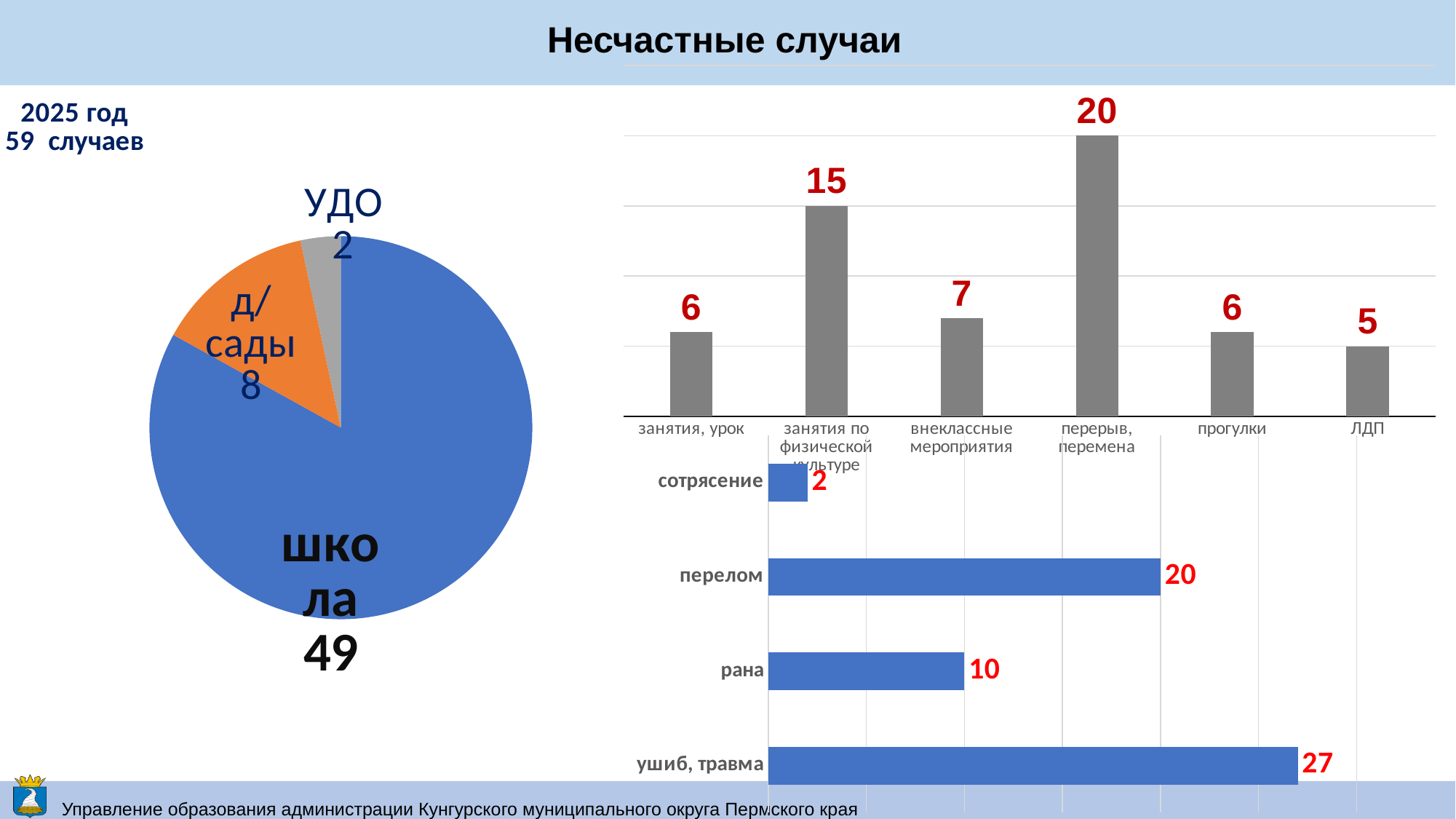
In the vertical bar chart at the top right, how many categories are shown? 6 In the vertical bar chart at the top right, what is the value for перерыв, перемена? 20 In the horizontal bar chart at the bottom right, what is the value for рана? 10 What kind of chart is shown at the bottom right of the slide? bar chart In the pie chart on the left, what is the value for школа? 49 In the horizontal bar chart at the bottom right, which category has the highest value? ушиб, травма In the horizontal bar chart at the bottom right, which is larger: перелом or сотрясение? перелом In the vertical bar chart at the top right, what is the difference between занятия по физической культуре and внеклассные мероприятия? 8 In the pie chart on the left, what is the difference between the values for д/сады and УДО? 6 In the pie chart on the left, which category has the smallest slice? УДО In the vertical bar chart at the top right, which category has the lowest value? ЛДП